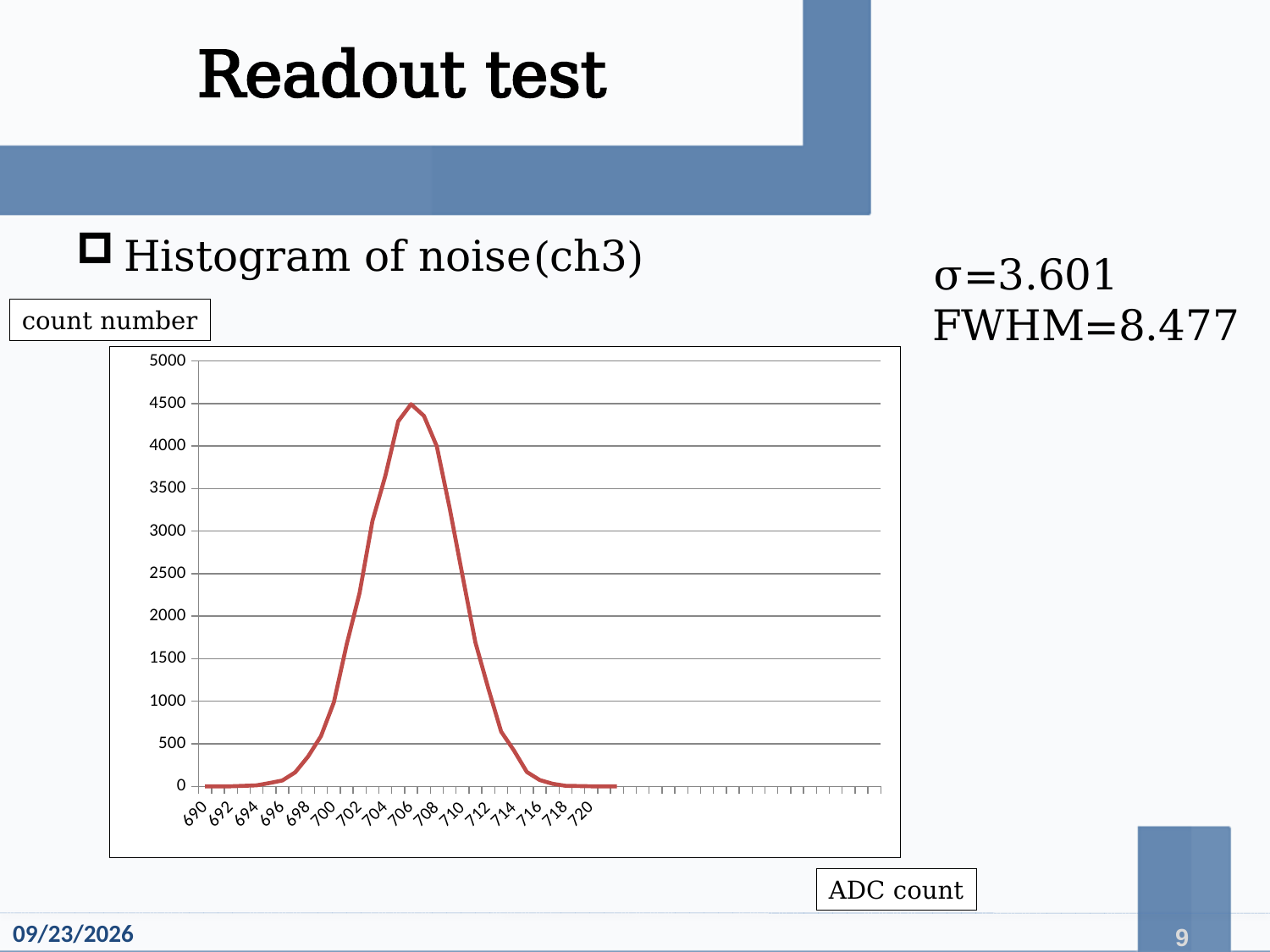
Is the count number at ADC count 702 greater or less than 2000? greater Is the count number at ADC count 706 greater or less than 4000? greater Is the count number at ADC count 704 greater or less than 3000? greater At which ADC count does the histogram reach its highest count number? 706 Does the count number rise or fall as the ADC count goes from 690 to 706? rise What is the label given for the horizontal axis of the chart? ADC count What is the label given for the vertical axis of the chart? count number What kind of chart is shown on the slide? line chart Does the count number rise or fall as the ADC count goes from 706 to 720? fall Which of ADC count 700 or ADC count 704 has the larger count number? 704